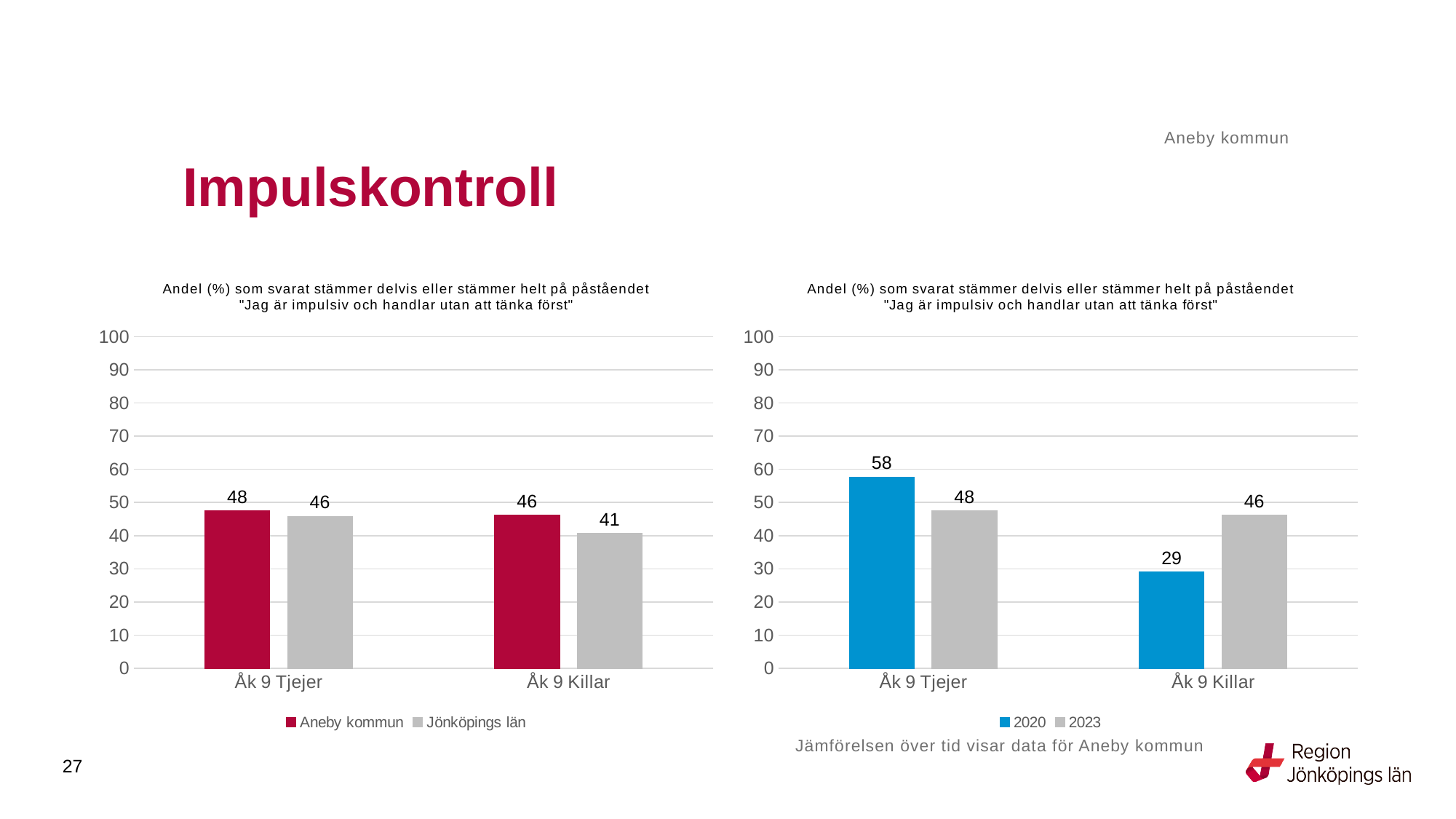
In the right chart, what is the value for 2023 for Åk 9 Tjejer? 48 How many series does the legend of the left chart list? 2 What kind of chart is the right chart? Bar chart In the right chart, what is the difference between 2020 and 2023 for Åk 9 Killar? 17 In the right chart, which bar has the lowest value? 2020, Åk 9 Killar What are the two legend entries of the right chart? 2020 and 2023 In the right chart, what is the value for 2020 for Åk 9 Killar? 29 In the right chart, which is larger for Åk 9 Tjejer: 2020 or 2023? 2020 In the right chart, which bar has the highest value? 2020, Åk 9 Tjejer In the left chart, what is the value for Aneby kommun for Åk 9 Tjejer? 48 In the left chart, what is the difference between Aneby kommun and Jönköpings län for Åk 9 Killar? 5 In the left chart, what is the value for Jönköpings län for Åk 9 Killar? 41